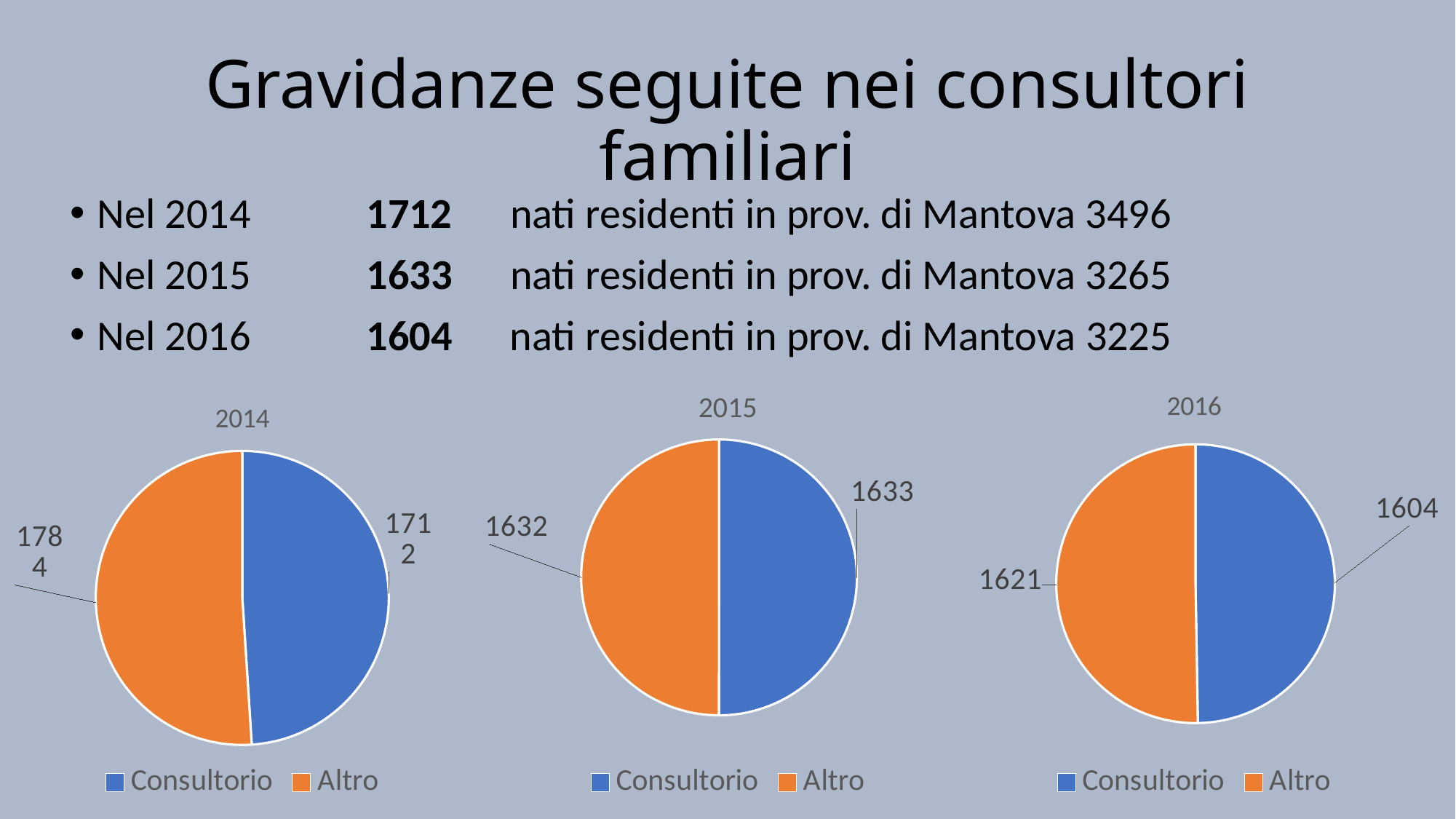
In the 2014 pie chart, what is the difference between the Altro and Consultorio values? 72 In the 2014 pie chart, what is the value for Altro? 1784 In the 2014 pie chart, which slice is larger, Consultorio or Altro? Altro In the 2015 pie chart, what is the value for Altro? 1632 In the 2014 pie chart, what is the value for Consultorio? 1712 In the 2016 pie chart, what is the total of the two slices? 3225 What kind of chart is the 2015 chart? Pie chart How many series does the legend of the 2016 chart list? 2 In the 2015 pie chart, what is the difference between the Consultorio and Altro values? 1 In the 2016 pie chart, which slice is larger, Consultorio or Altro? Altro In the 2016 pie chart, what is the value for Altro? 1621 In the 2016 pie chart, what is the value for Consultorio? 1604